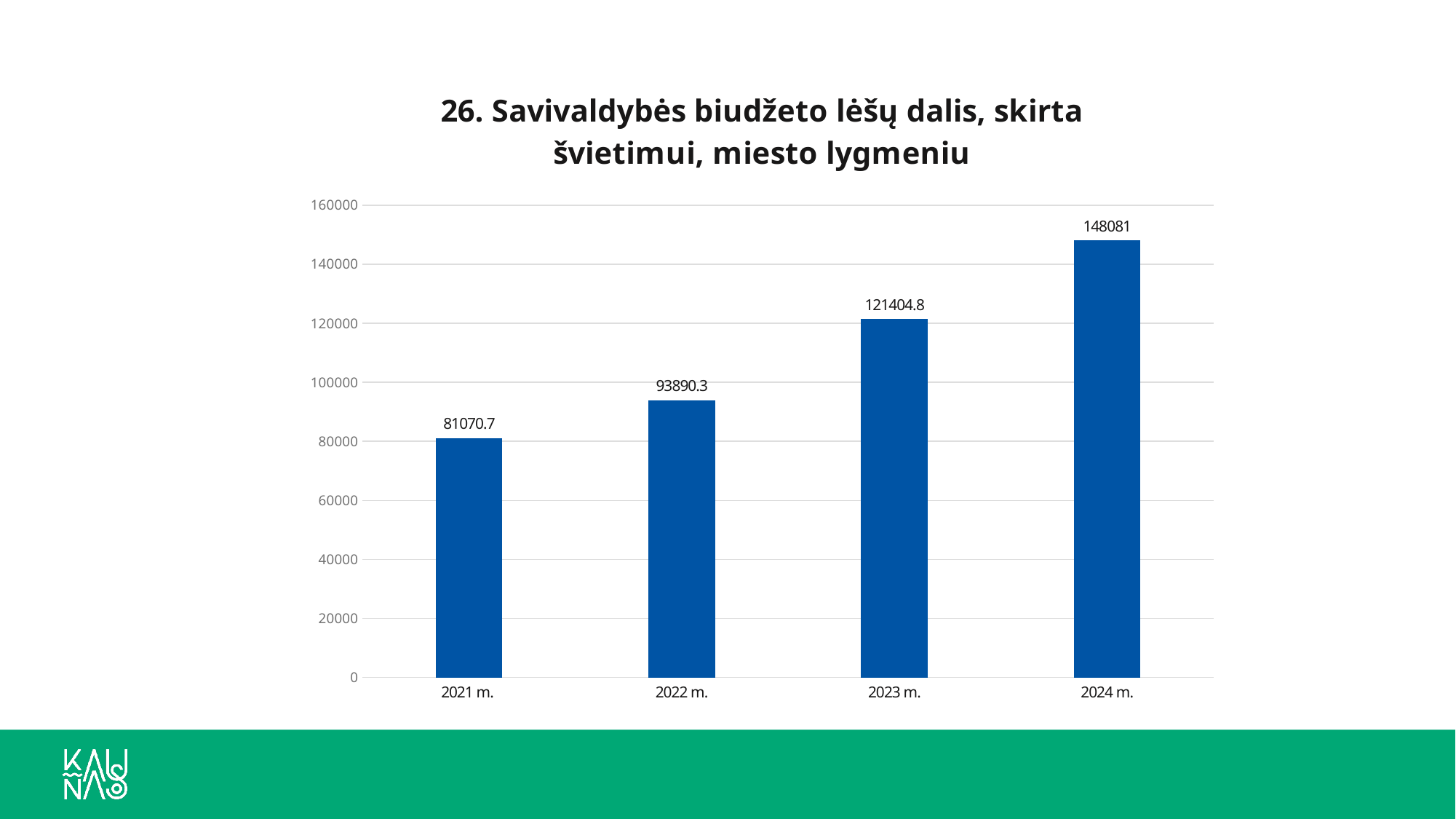
Do the values rise or fall from 2021 m. to 2024 m.? Rise How many years are shown on the x axis? 4 Which is larger, the value for 2022 m. or the value for 2023 m.? 2023 m. What kind of chart is shown on the slide? Bar chart Which year has the highest value? 2024 m. What is the difference between the values for 2023 m. and 2022 m.? 27514.5 Which year has the lowest value? 2021 m. What is the value for 2022 m.? 93890.3 What is the value for 2021 m.? 81070.7 What is the difference between the values for 2024 m. and 2021 m.? 67010.3 What is the value for 2023 m.? 121404.8 What is the value for 2024 m.? 148081